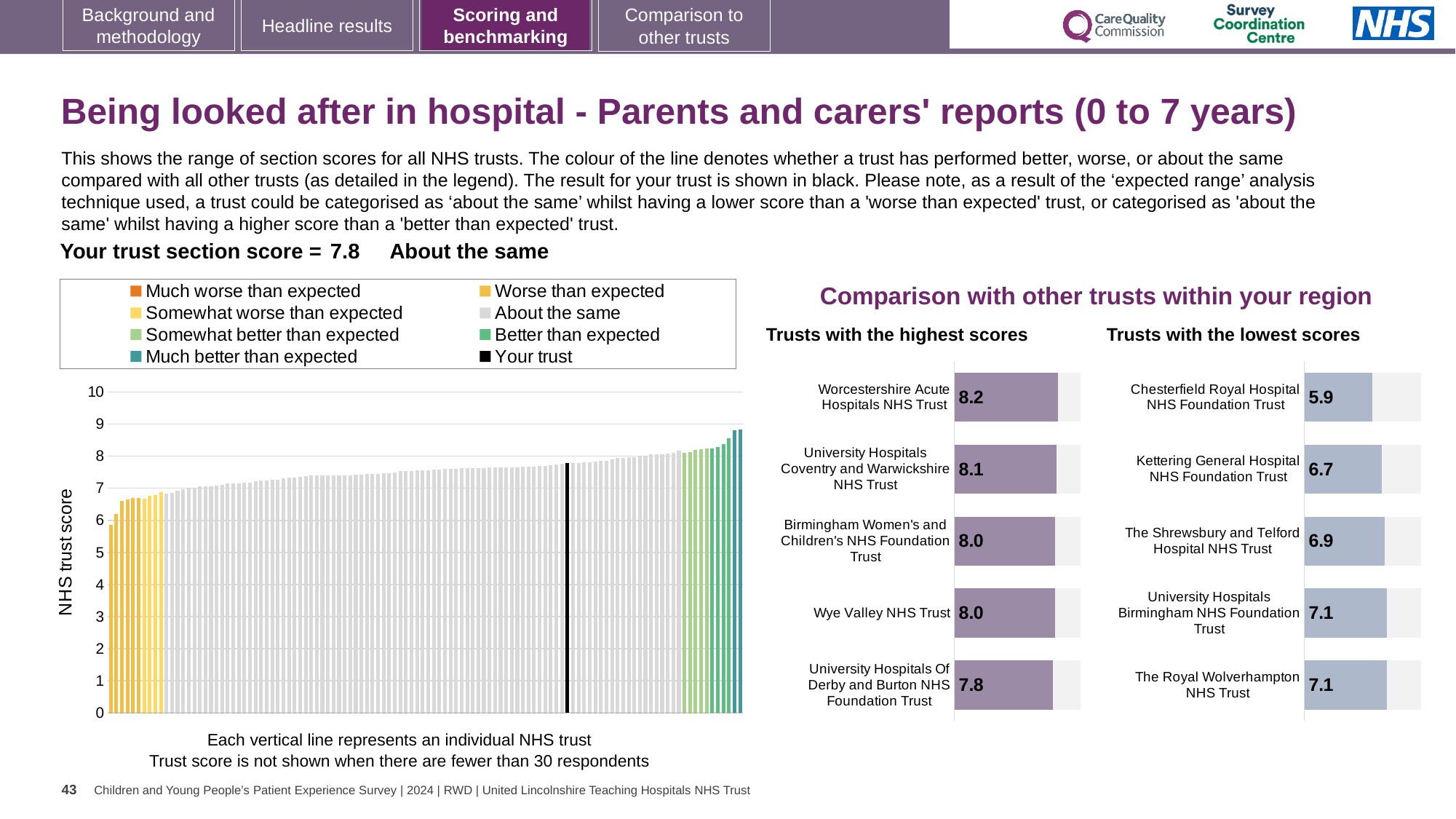
What type of chart is the large chart on the left showing the range of section scores for all NHS trusts? Bar chart In the 'Trusts with the lowest scores' chart, which trust has the highest score shown? University Hospitals Birmingham NHS Foundation Trust and The Royal Wolverhampton NHS Trust (both 7.1) In the large chart on the left, do the trust scores rise or fall from left to right along the x axis? Rise In the 'Trusts with the highest scores' chart, what is the score for Worcestershire Acute Hospitals NHS Trust? 8.2 How many entries does the legend above the large chart on the left list? 8 In the 'Trusts with the highest scores' chart, which trust has the lowest score shown? University Hospitals Of Derby and Burton NHS Foundation Trust In the 'Trusts with the highest scores' chart, what is the difference between the scores of Worcestershire Acute Hospitals NHS Trust and University Hospitals Of Derby and Burton NHS Foundation Trust? 0.4 In the 'Trusts with the lowest scores' chart, what is the score for Chesterfield Royal Hospital NHS Foundation Trust? 5.9 In the 'Trusts with the lowest scores' chart, which has the larger score: Kettering General Hospital NHS Foundation Trust or The Shrewsbury and Telford Hospital NHS Trust? The Shrewsbury and Telford Hospital NHS Trust In the large chart on the left, is the value for 'Your trust' (the black line) greater or less than 7? greater In the 'Trusts with the lowest scores' chart, what is the difference between the scores of Kettering General Hospital NHS Foundation Trust and Chesterfield Royal Hospital NHS Foundation Trust? 0.8 In the 'Trusts with the highest scores' chart, how many trusts are listed? 5